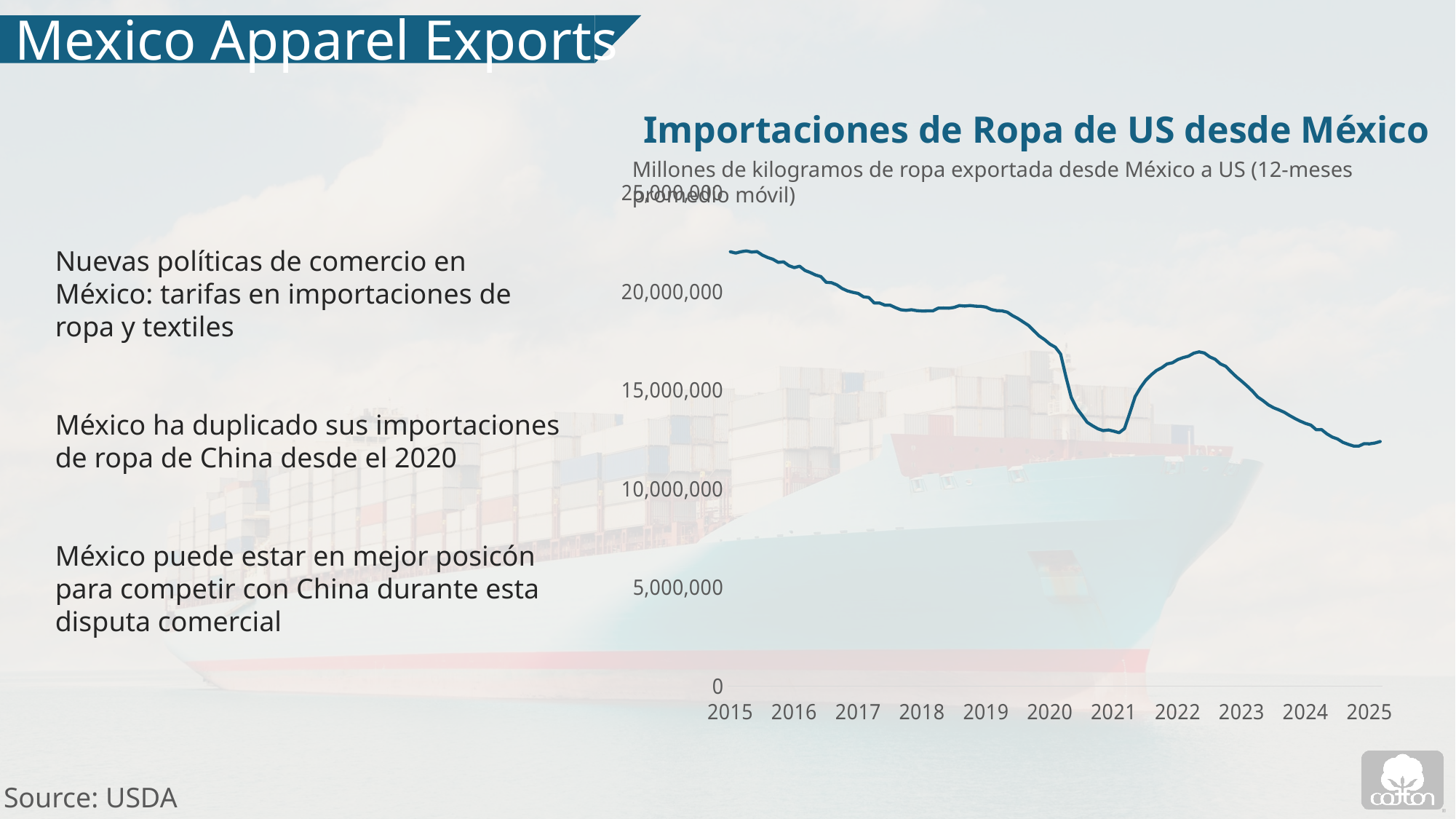
What kind of chart is shown on the slide? line chart Which year shows the highest value on the chart? 2015 Is the value in 2017 greater or less than 15,000,000? greater What is the source cited for the chart? USDA Which is larger, the value in 2015 or the value in 2025? 2015 Is the value in 2025 greater or less than 15,000,000? less How many years are labelled on the x axis of the chart? 11 Is the value in 2022 greater or less than 15,000,000? greater Overall, do the values rise or fall from 2015 to 2025? fall What is the title of the chart? Importaciones de Ropa de US desde México